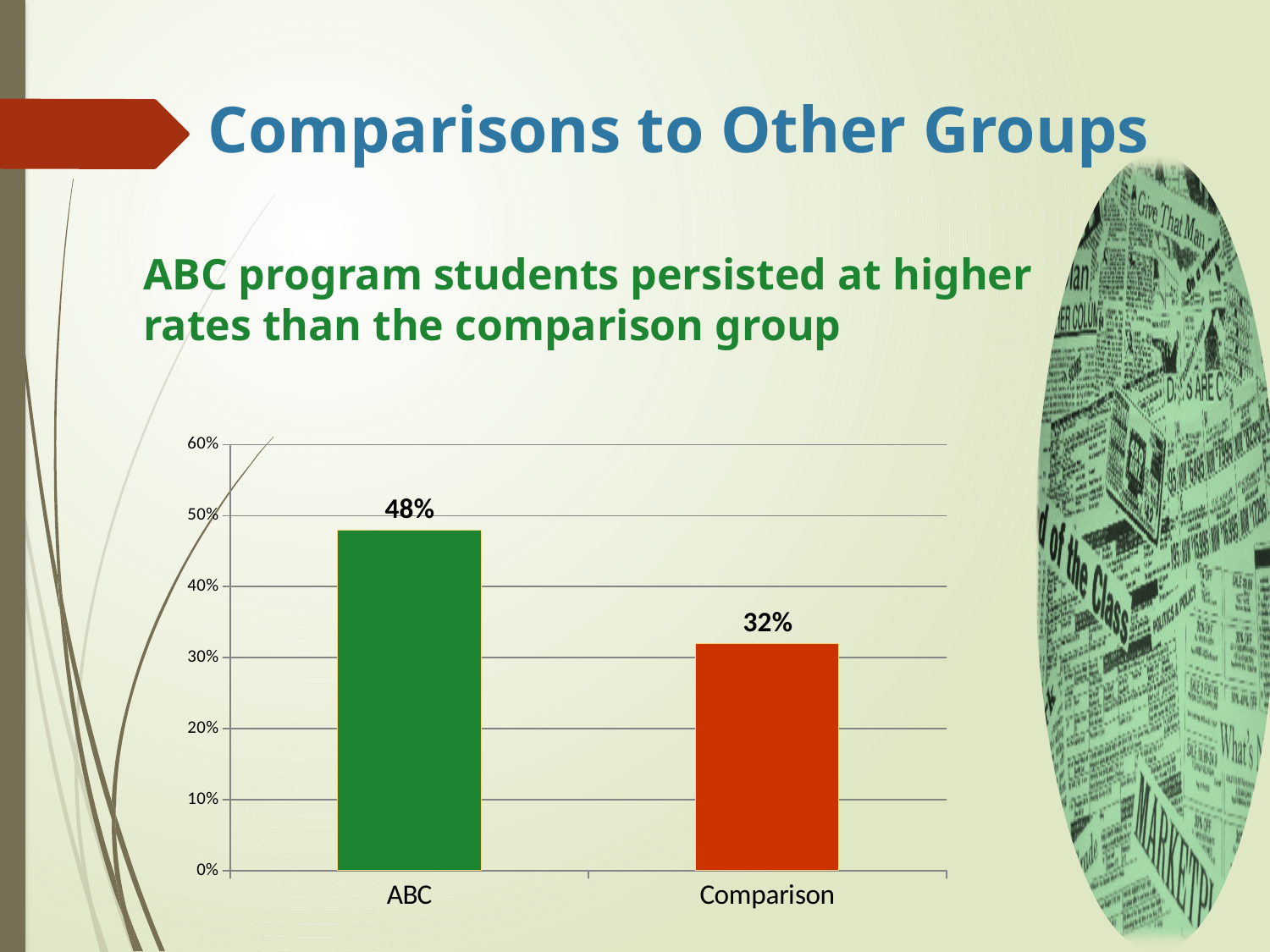
What colour is the bar for ABC? green Which category has the lowest value? Comparison Which is larger, the value for ABC or the value for Comparison? ABC Is the value for Comparison greater or less than 40%? less What is the difference between the values for ABC and Comparison? 16% What is the value for ABC? 48% What is the highest value shown on the y axis? 60% What kind of chart is shown on the slide? bar chart How many categories are shown on the x axis? 2 Which category has the highest value? ABC What is the value for Comparison? 32% Is the value for ABC greater or less than 40%? greater